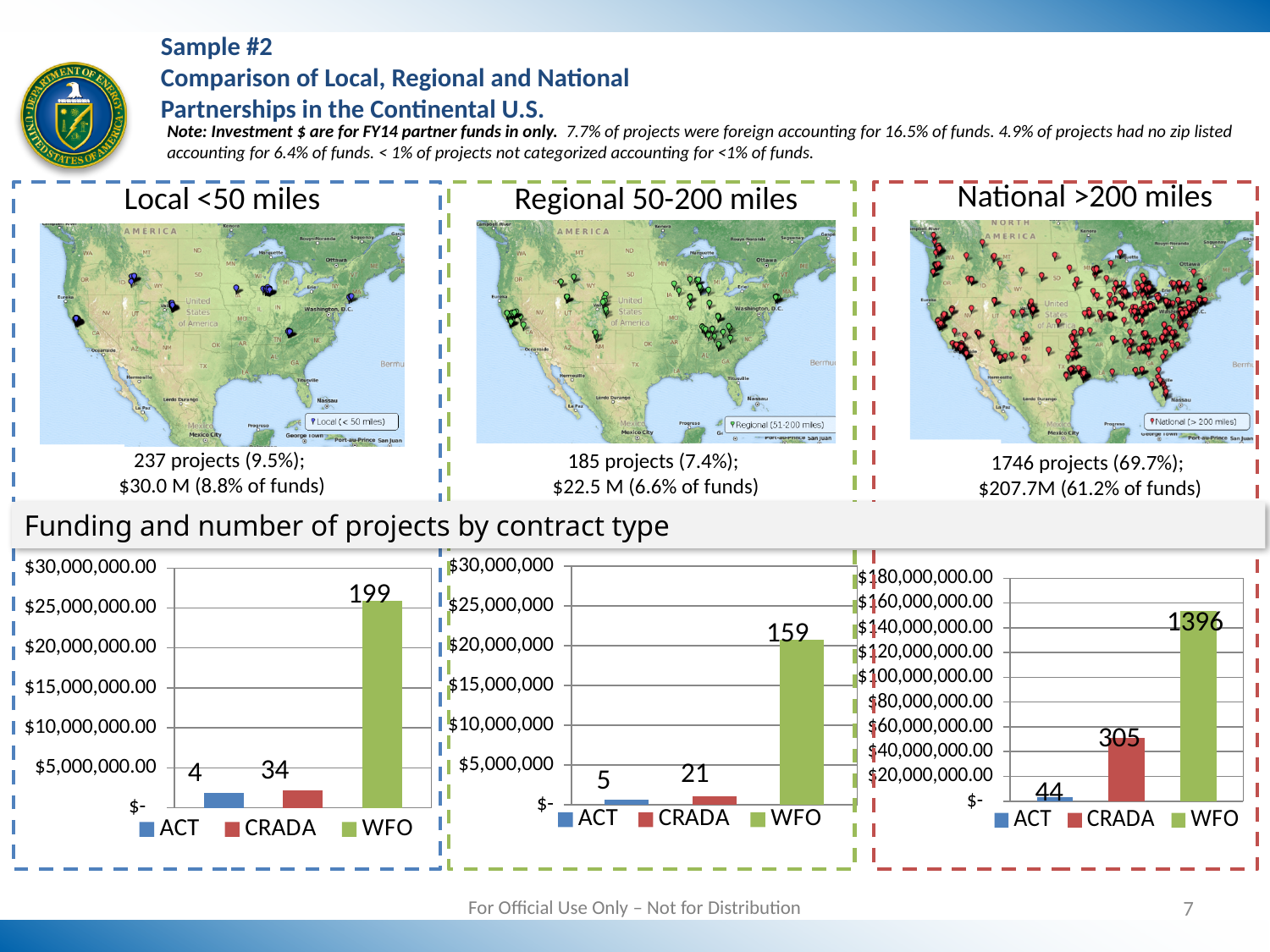
In the National >200 miles chart, what is the difference between the numbers printed for WFO and CRADA? 1091 In the Local <50 miles chart, is the value for CRADA greater or less than $5,000,000.00? less In the National >200 miles chart, which contract type has the tallest bar? WFO In the National >200 miles chart, what number is printed above the ACT bar? 44 In the Local <50 miles chart, what is the difference between the numbers printed for WFO and CRADA? 165 How many contract types does the legend of the Regional 50-200 miles chart list? 3 In the National >200 miles chart, is the value for WFO greater or less than $100,000,000.00? greater In the Local <50 miles chart, which contract type has the shortest bar? ACT What kind of chart is used in the Local <50 miles panel for funding by contract type? bar chart In the Local <50 miles chart, what number is printed above the WFO bar? 199 In the Regional 50-200 miles chart, is the bar for CRADA or ACT taller? CRADA In the Regional 50-200 miles chart, what number is printed above the CRADA bar? 21